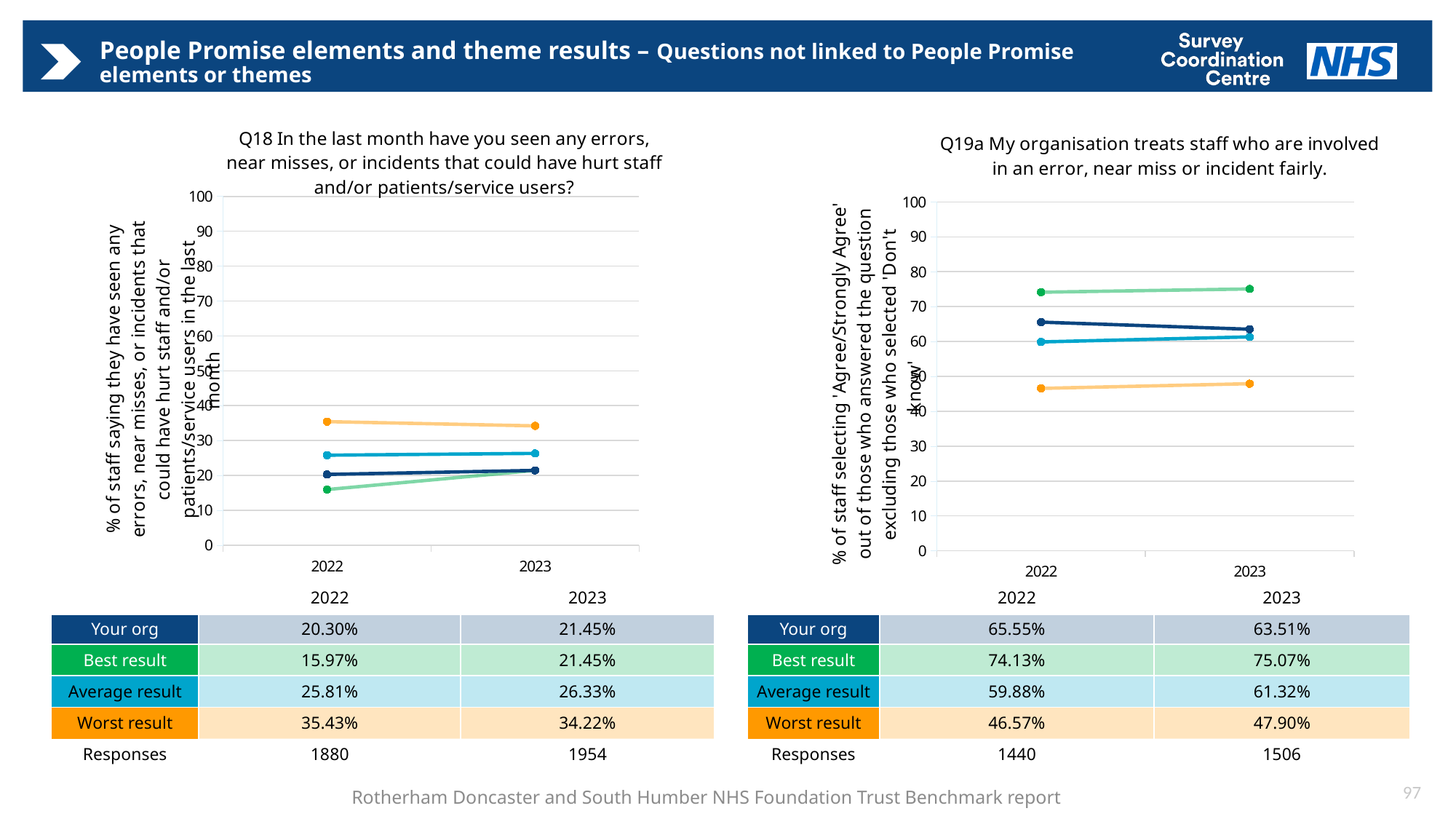
In the Q19a chart, what is the difference between the Best result and Worst result values in 2022? 27.56% In the Q18 chart, what is the value for Your org in 2023? 21.45% In the Q18 chart, what is the Worst result value for 2022? 35.43% In the Q19a chart, which series has the highest value in 2023? Best result In the Q18 chart, which series has the lowest value in 2022? Best result What kind of chart is the Q19a chart? line chart In the Q19a chart, what is the Average result value for 2022? 59.88% In the Q19a chart, does the Your org value rise or fall from 2022 to 2023? fall In the Q18 chart, is the Your org value for 2022 larger or smaller than the Average result value for 2022? smaller In the Q19a chart, what is the Best result value for 2023? 75.07% In the Q18 chart, does the Best result value rise or fall from 2022 to 2023? rise How many series are plotted in the Q18 chart? 4